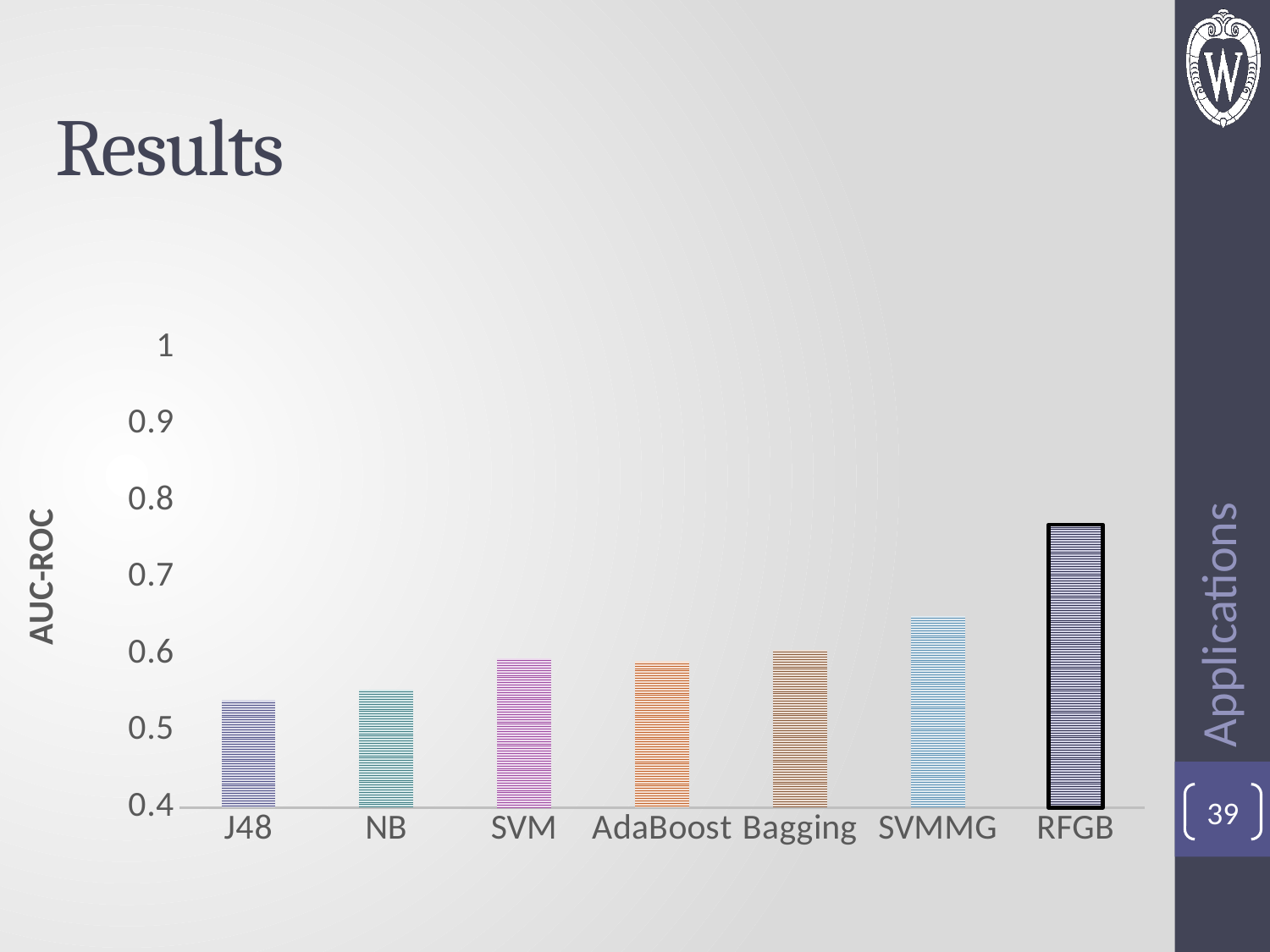
Is the AUC-ROC value for SVMMG greater or less than 0.6? greater Is the AUC-ROC value for J48 greater or less than 0.6? less Which has a higher AUC-ROC, SVM or J48? SVM Is the AUC-ROC value for RFGB greater or less than 0.8? less How many methods are compared along the x axis of the chart? 7 Which has a higher AUC-ROC, SVMMG or Bagging? SVMMG What kind of chart is shown on the slide? bar chart Which method has the highest AUC-ROC in the chart? RFGB What is the label of the vertical axis of the chart? AUC-ROC Which has a higher AUC-ROC, RFGB or SVMMG? RFGB